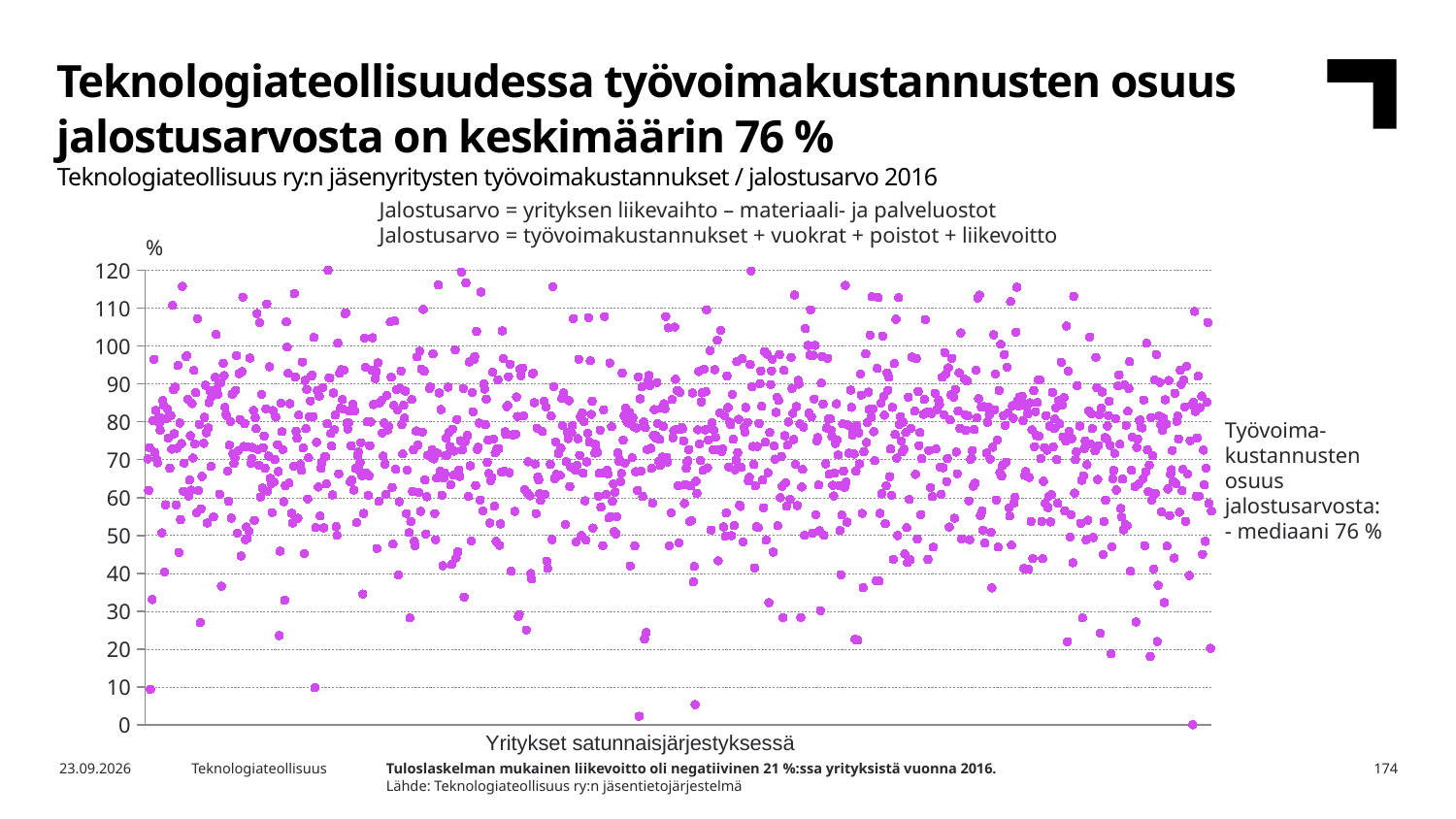
Is the median value of 76 % stated on the slide greater or less than 70 on the vertical axis? greater What unit is shown at the top of the vertical axis? % What is the lowest tick value on the vertical axis? 0 What is the median share of labour costs in value added stated next to the chart? 76 % What is the label of the horizontal axis? Yritykset satunnaisjärjestyksessä Is the median value of 76 % stated on the slide greater or less than 80 on the vertical axis? less What is the interval between consecutive tick marks on the vertical axis? 10 Which year's data does the chart show? 2016 What is the highest value shown on the vertical axis of the chart? 120 According to the footnote, in what percentage of companies was the operating profit negative in 2016? 21 % What kind of chart is shown on the slide? Scatter plot